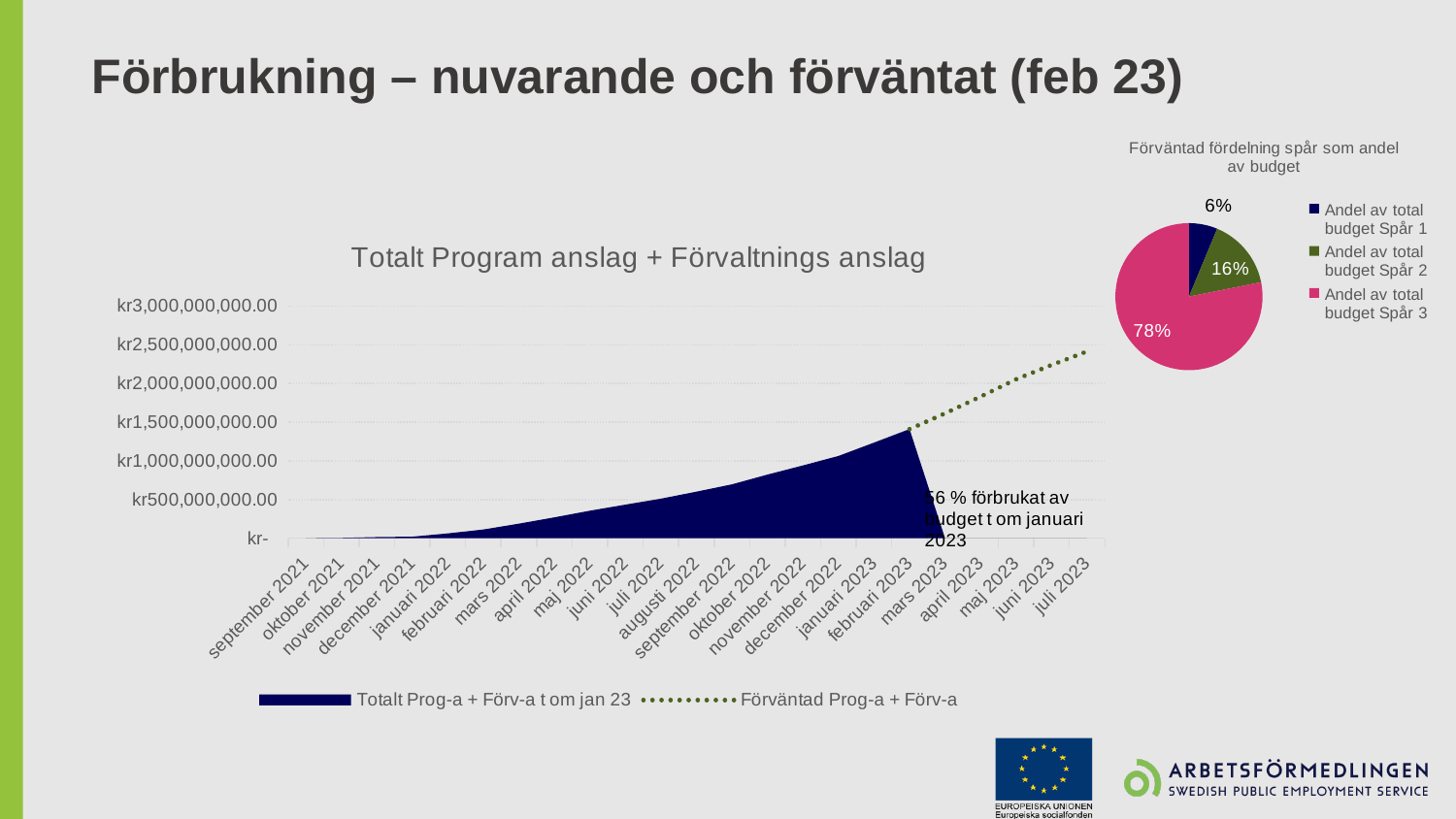
In the pie chart 'Förväntad fördelning spår som andel av budget', which slice is the smallest? Andel av total budget Spår 1 In the chart 'Totalt Program anslag + Förvaltnings anslag', do the values rise or fall from september 2021 to juli 2023? Rise How many series does the legend of the chart 'Totalt Program anslag + Förvaltnings anslag' list? 2 In the pie chart 'Förväntad fördelning spår som andel av budget', what is the difference in percentage points between Spår 3 and Spår 2? 62 In the chart 'Totalt Program anslag + Förvaltnings anslag', is the value for januari 2023 greater or less than kr1,000,000,000.00? greater In the chart 'Totalt Program anslag + Förvaltnings anslag', how many months are shown on the x axis? 23 In the pie chart 'Förväntad fördelning spår som andel av budget', which slice is the largest? Andel av total budget Spår 3 In the pie chart 'Förväntad fördelning spår som andel av budget', what share is 'Andel av total budget Spår 1'? 6% In the pie chart 'Förväntad fördelning spår som andel av budget', what share is 'Andel av total budget Spår 3'? 78% In the chart 'Totalt Program anslag + Förvaltnings anslag', is the value for mars 2022 greater or less than kr500,000,000.00? less What kind of chart is 'Totalt Program anslag + Förvaltnings anslag'? Combination area and line chart (a filled area plus a dotted line) How many slices does the pie chart 'Förväntad fördelning spår som andel av budget' have? 3